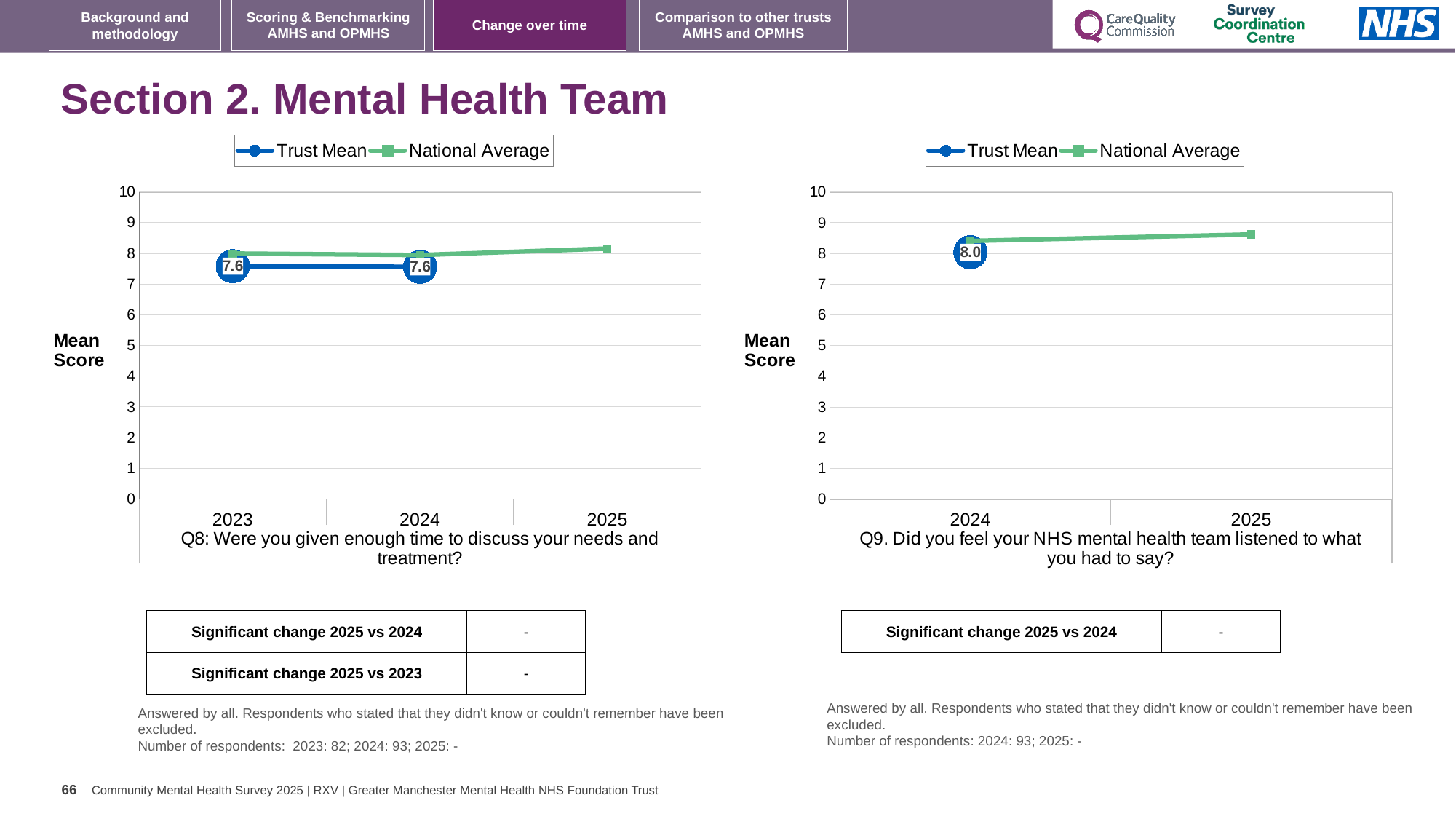
In the Q8 chart on the left, is the National Average value for 2025 greater or less than 7? greater In the Q9 chart on the right, what is the Trust Mean for 2024? 8.0 How many years are shown on the x axis of the Q8 chart on the left? 3 In the Q8 chart on the left, what is the Trust Mean for 2023? 7.6 How many series does the legend of the Q9 chart on the right list? 2 What kind of chart is the Q8 chart on the left? Line chart In the Q8 chart on the left, what is the Trust Mean for 2024? 7.6 In the Q8 chart on the left, does the Trust Mean rise, fall or stay the same from 2023 to 2024? Stays the same In the Q8 chart on the left, what is the difference between the Trust Mean for 2024 and the Trust Mean for 2023? 0 In the Q9 chart on the right, is the National Average value for 2025 greater or less than 9? less What are the two series named in the legend of the Q8 chart on the left? Trust Mean and National Average How many years are shown on the x axis of the Q9 chart on the right? 2